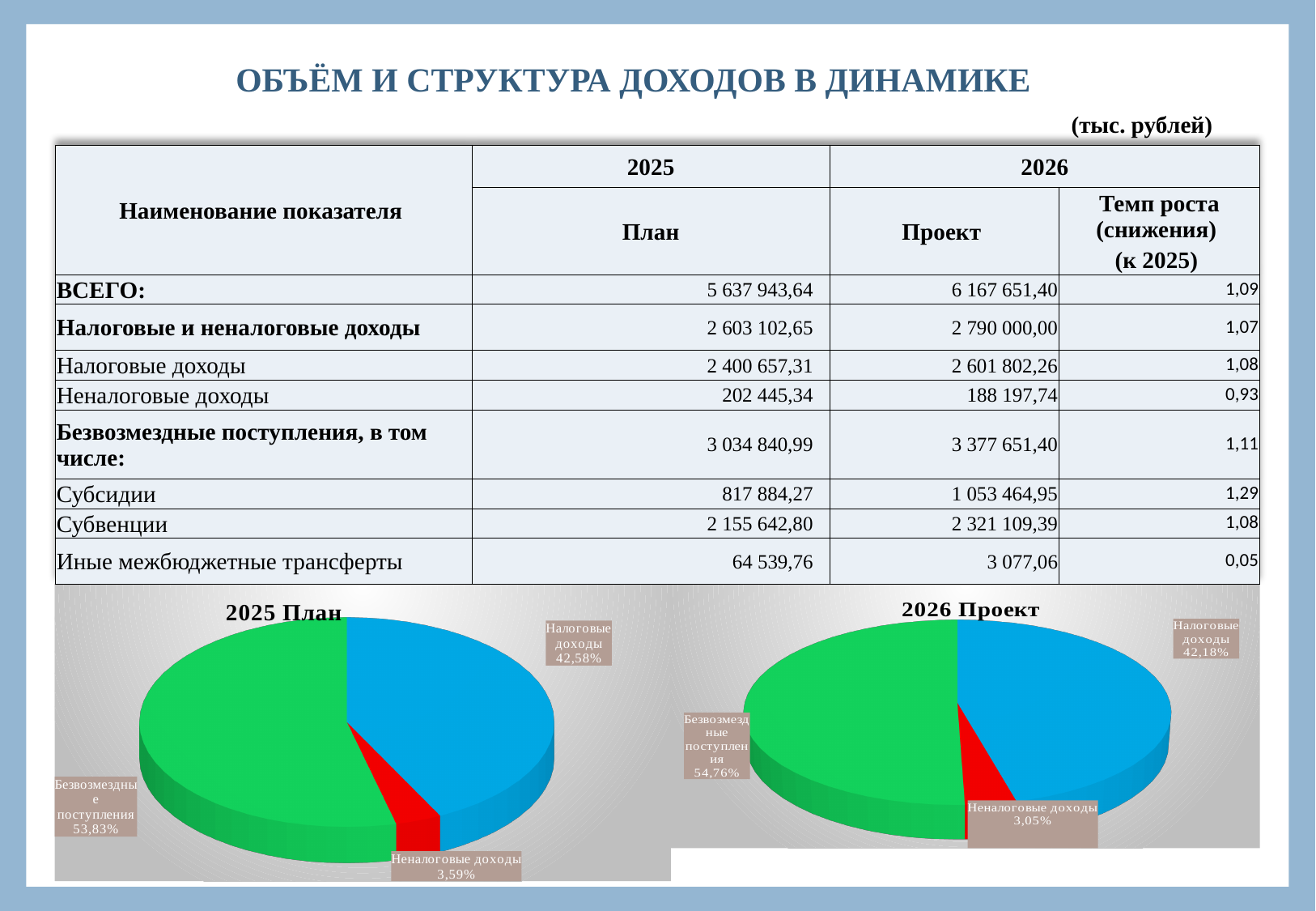
In the "2026 Проект" pie chart, what share is shown for Безвозмездные поступления? 54,76% In the "2025 План" pie chart, what share is shown for Безвозмездные поступления? 53,83% In the "2026 Проект" pie chart, what colour is the Неналоговые доходы slice? red In the "2025 План" pie chart, what share is shown for Налоговые доходы? 42,58% In the "2026 Проект" pie chart, what share is shown for Неналоговые доходы? 3,05% In the "2025 План" pie chart, what share is shown for Неналоговые доходы? 3,59% In the "2026 Проект" pie chart, what share is shown for Налоговые доходы? 42,18% What kind of chart is the "2025 План" chart? pie chart How many slices does the "2026 Проект" pie chart have? 3 In the "2025 План" pie chart, which category has the largest slice? Безвозмездные поступления In the "2025 План" pie chart, what is the difference between the shares of Безвозмездные поступления and Налоговые доходы? 11,25% In the "2026 Проект" pie chart, which category has the smallest slice? Неналоговые доходы